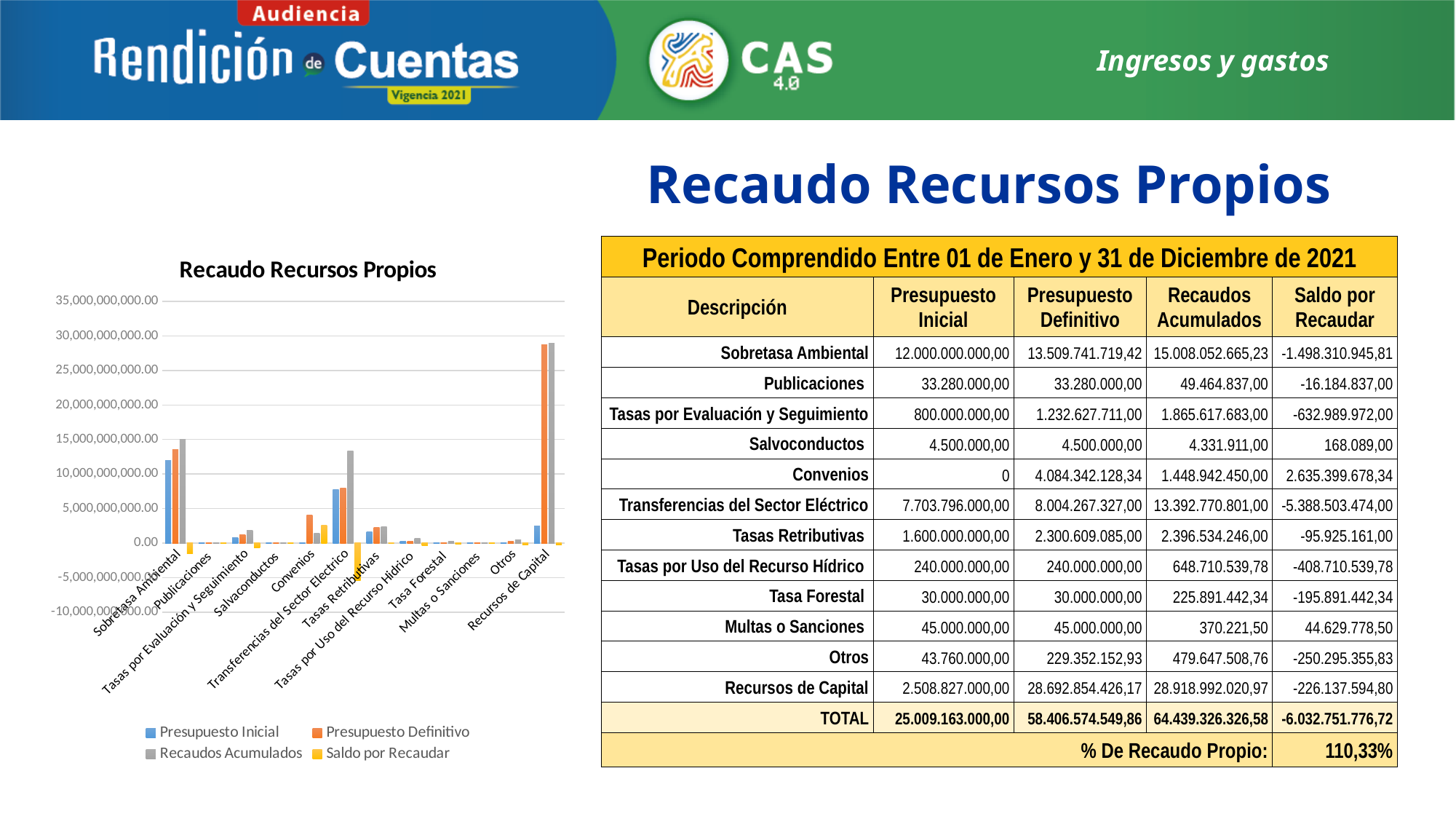
In the 'Recaudo Recursos Propios' chart, is the Saldo por Recaudar value for Transferencias del Sector Eléctrico greater or less than 0.00? less In the 'Recaudo Recursos Propios' chart, is the Presupuesto Definitivo value for Recursos de Capital greater or less than 25,000,000,000.00? greater How many categories are shown on the x axis of the 'Recaudo Recursos Propios' chart? 12 What is the Presupuesto Inicial value for Sobretasa Ambiental, as printed in the table on the slide? 12.000.000.000,00 In the 'Recaudo Recursos Propios' chart, which has the larger Recaudos Acumulados bar: Transferencias del Sector Eléctrico or Tasas Retributivas? Transferencias del Sector Eléctrico What is the title of the chart on the left of the slide? Recaudo Recursos Propios In the 'Recaudo Recursos Propios' chart, which category has the highest Recaudos Acumulados bar? Recursos de Capital What kind of chart is 'Recaudo Recursos Propios'? bar chart In the 'Recaudo Recursos Propios' chart, which is larger for Convenios: Presupuesto Inicial or Presupuesto Definitivo? Presupuesto Definitivo In the 'Recaudo Recursos Propios' chart, is the Recaudos Acumulados value for Sobretasa Ambiental greater or less than 10,000,000,000.00? greater How many series does the legend of the 'Recaudo Recursos Propios' chart list? 4 In the 'Recaudo Recursos Propios' chart, what colour represents the Saldo por Recaudar series? yellow